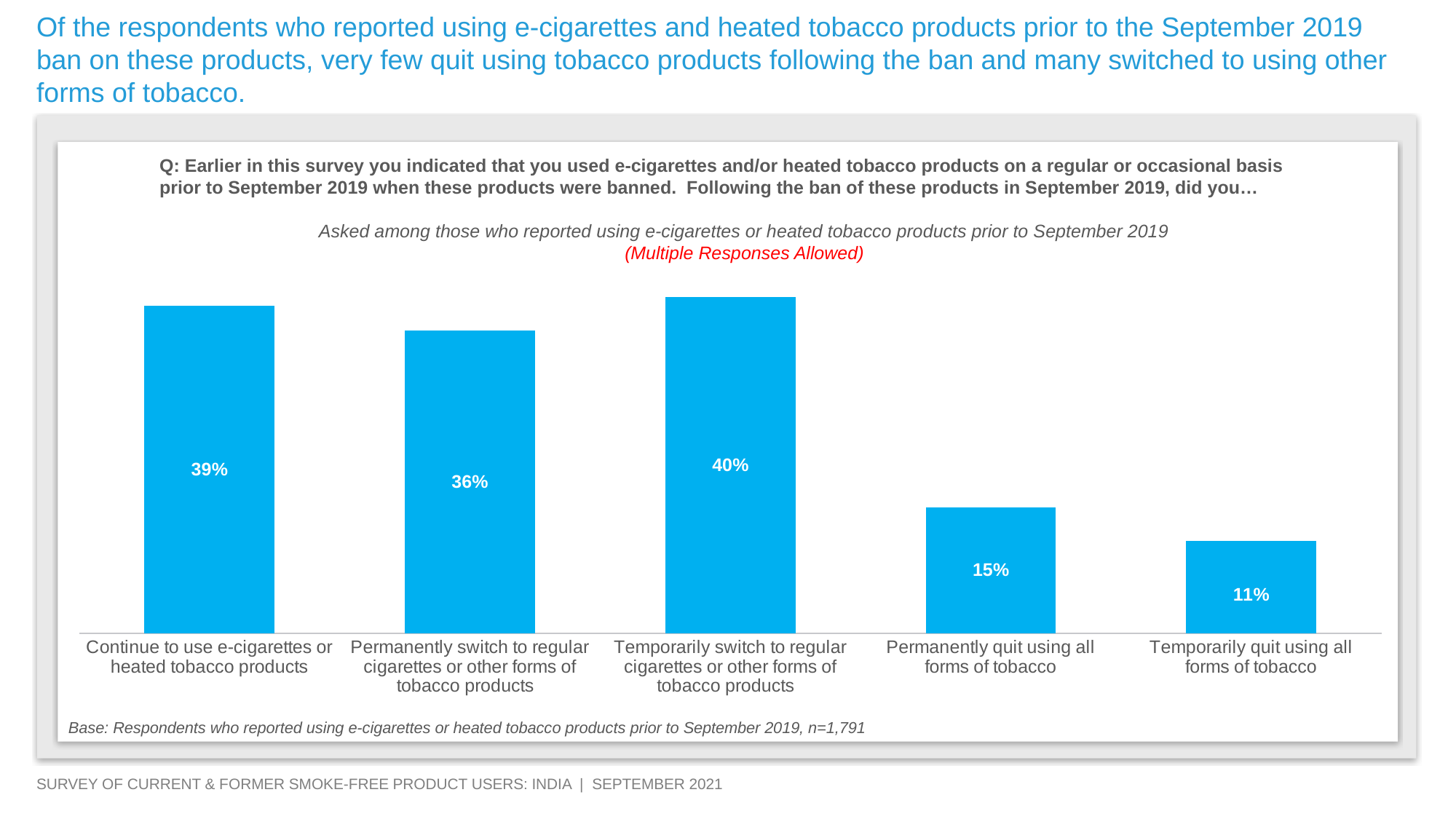
What type of chart is shown on the slide? Bar chart What is the base size (n) of respondents for this chart? 1,791 Which is larger: the percentage who continued to use e-cigarettes or heated tobacco products, or the percentage who permanently switched to regular cigarettes or other forms of tobacco products? Continue to use e-cigarettes or heated tobacco products What percentage of respondents permanently quit using all forms of tobacco? 15% What percentage of respondents temporarily quit using all forms of tobacco? 11% What percentage of respondents permanently switched to regular cigarettes or other forms of tobacco products? 36% Which response has the lowest percentage? Temporarily quit using all forms of tobacco How many response categories are shown in the chart? 5 Which response has the highest percentage? Temporarily switch to regular cigarettes or other forms of tobacco products What is the difference in percentage points between those who permanently quit and those who temporarily quit using all forms of tobacco? 4 What is the difference in percentage points between those who temporarily switched to regular cigarettes or other tobacco products and those who permanently quit using all forms of tobacco? 25 What percentage of respondents said they continued to use e-cigarettes or heated tobacco products after the ban? 39%